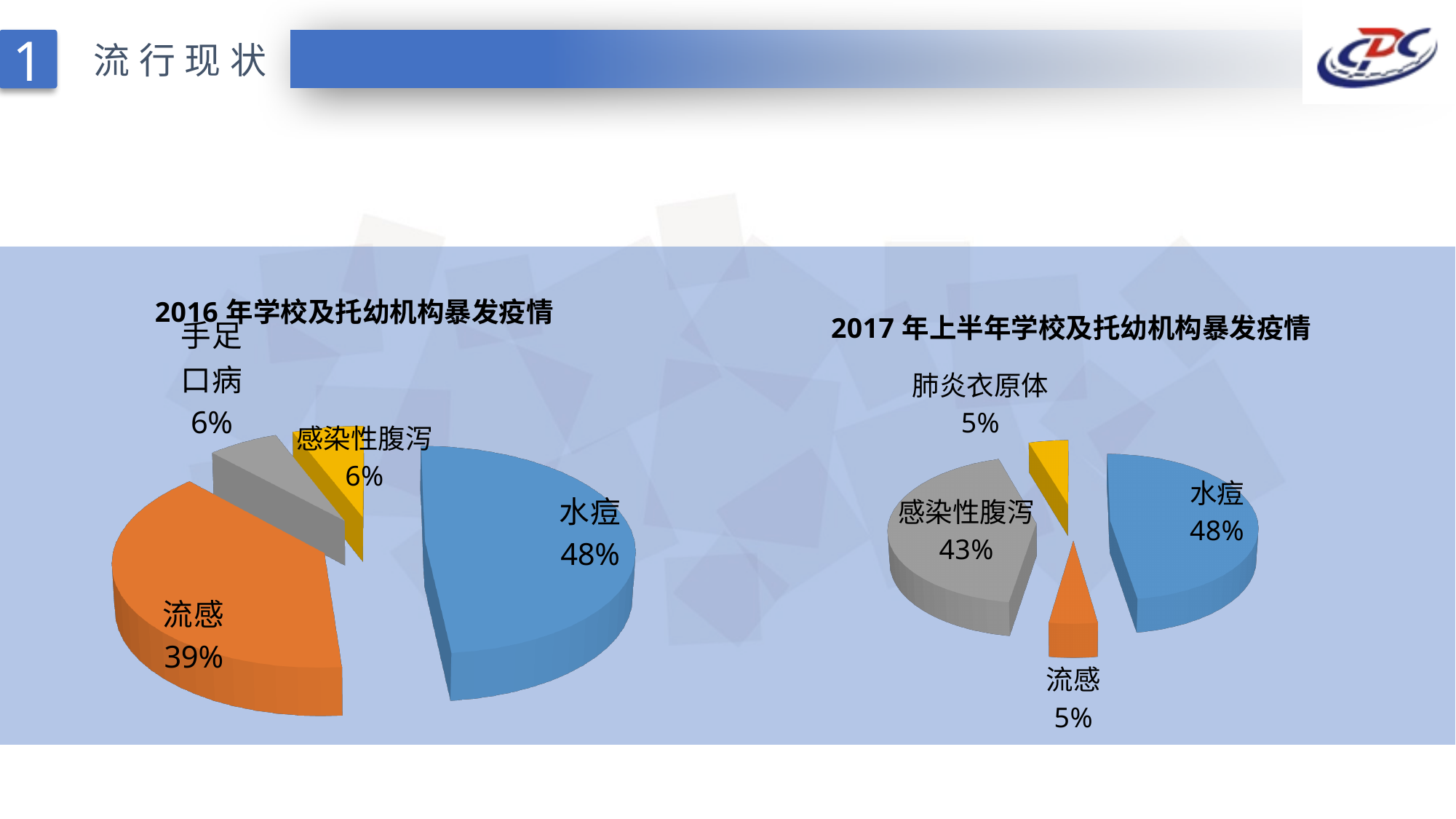
In the 2017 年上半年学校及托幼机构暴发疫情 chart, what share does 感染性腹泻 have? 43% What type of chart is the 2017 年上半年学校及托幼机构暴发疫情 chart? Pie chart In the 2017 年上半年学校及托幼机构暴发疫情 chart, which is larger, the share of 水痘 or the share of 感染性腹泻? 水痘 In the 2016 年学校及托幼机构暴发疫情 chart, which category has the largest share? 水痘 In the 2017 年上半年学校及托幼机构暴发疫情 chart, what share does 肺炎衣原体 have? 5% In the 2016 年学校及托幼机构暴发疫情 chart, how many slices does the pie have? 4 In the 2016 年学校及托幼机构暴发疫情 chart, what is the difference between the shares of 水痘 and 流感? 9% In the 2017 年上半年学校及托幼机构暴发疫情 chart, which category has the largest share? 水痘 In the 2016 年学校及托幼机构暴发疫情 chart, what share does 水痘 have? 48% In the 2016 年学校及托幼机构暴发疫情 chart, what share does 流感 have? 39% In the 2016 年学校及托幼机构暴发疫情 chart, what share does 手足口病 have? 6% In the 2017 年上半年学校及托幼机构暴发疫情 chart, what share does 流感 have? 5%